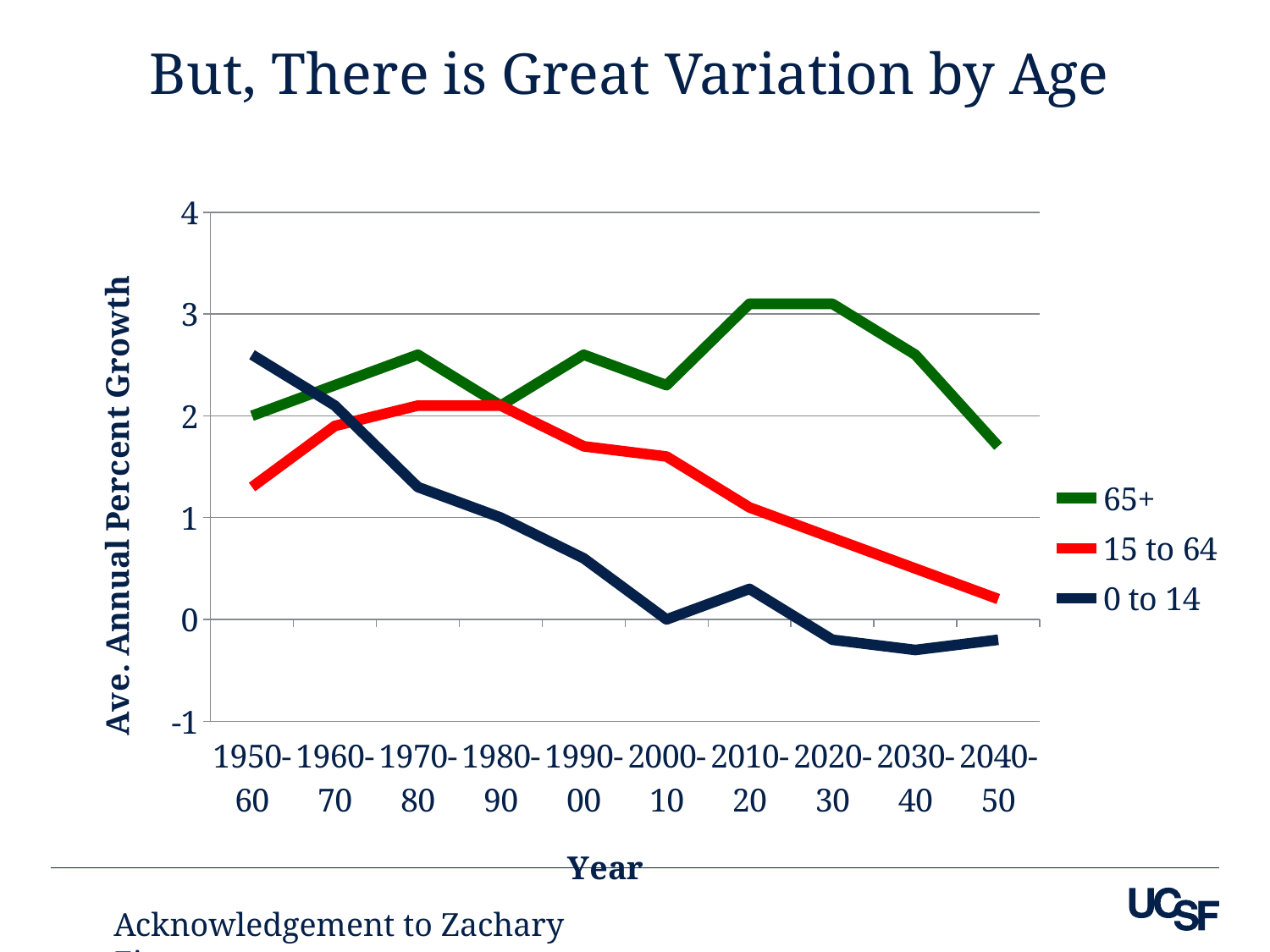
Is the value for 0 to 14 in 2020-30 greater or less than 0? less In which period is the growth for the 15 to 64 group lowest? 2040-50 Does the growth for the 15 to 64 group rise or fall from 1980-90 to 2040-50? fall How many year periods are shown along the x axis? 10 Which age group has the highest average annual percent growth in 2040-50? 65+ What kind of chart is shown on the slide? line chart In 1950-60, which is larger: the value for 0 to 14 or the value for 15 to 64? 0 to 14 In which period is the growth for the 0 to 14 group highest? 1950-60 What is the title of the y axis? Ave. Annual Percent Growth Is the value for 15 to 64 in 2040-50 greater or less than 1? less How many series does the legend list? 3 Is the value for 65+ in 2010-20 greater or less than 3? greater